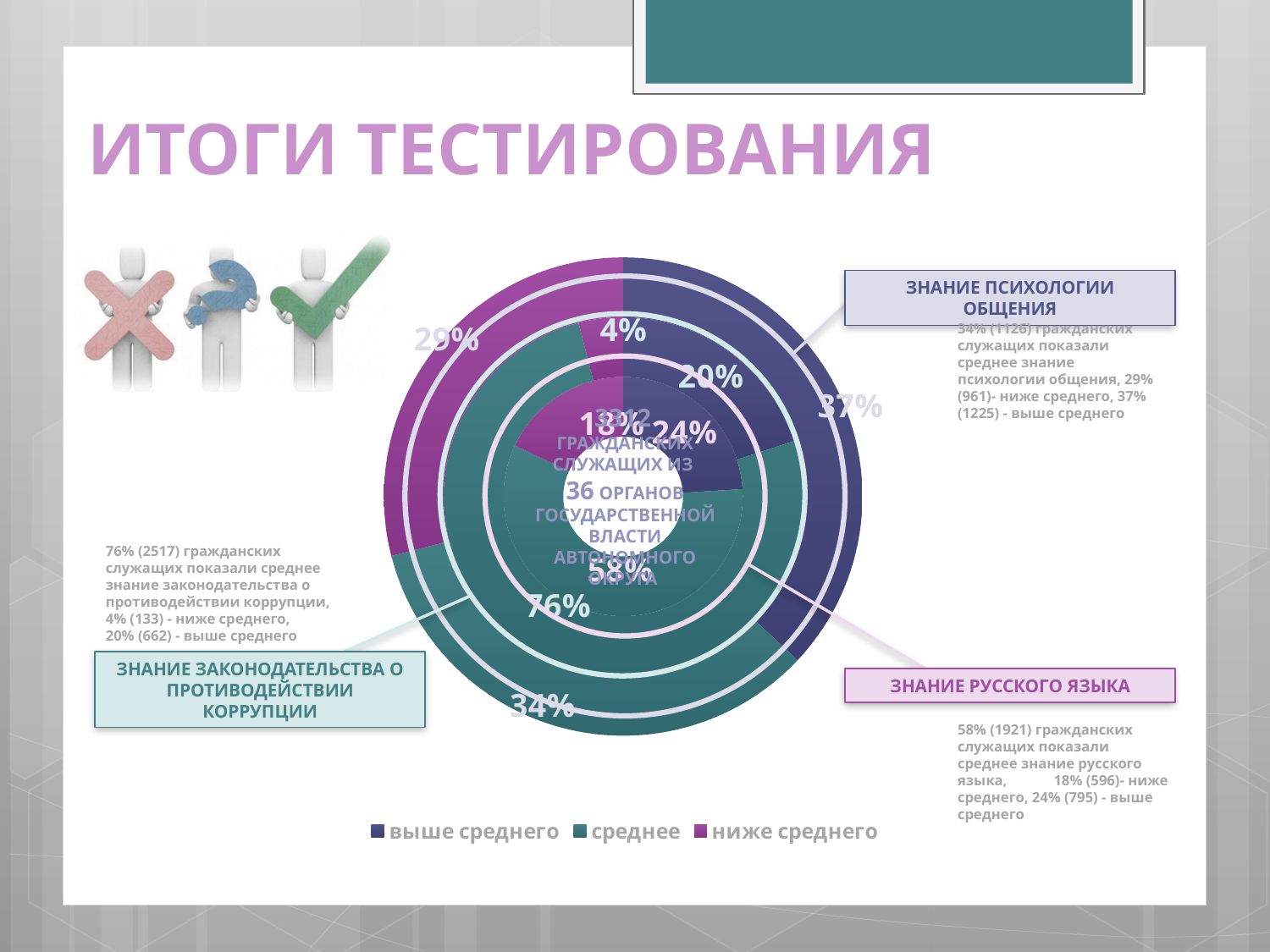
In the outer ring of the doughnut chart, what is the difference between the 'выше среднего' value (37%) and the 'ниже среднего' value (29%)? 8 percentage points How many entries does the chart legend list? 3 In the middle ring of the doughnut chart, what is the value for 'среднее'? 76% How many concentric rings does the doughnut chart have? 3 In the inner ring of the doughnut chart, which category has the smallest share? ниже среднего In the outer ring of the doughnut chart, what is the value for 'ниже среднего'? 29% In the middle ring of the doughnut chart, which category has the largest share? среднее In the outer ring of the doughnut chart, what is the value for 'выше среднего'? 37% In the middle ring of the doughnut chart, what is the value for 'ниже среднего'? 4% In the inner ring of the doughnut chart, which is larger: 'выше среднего' or 'ниже среднего'? выше среднего What kind of chart is shown on the slide? doughnut chart In the inner ring of the doughnut chart, what is the value for 'ниже среднего'? 18%